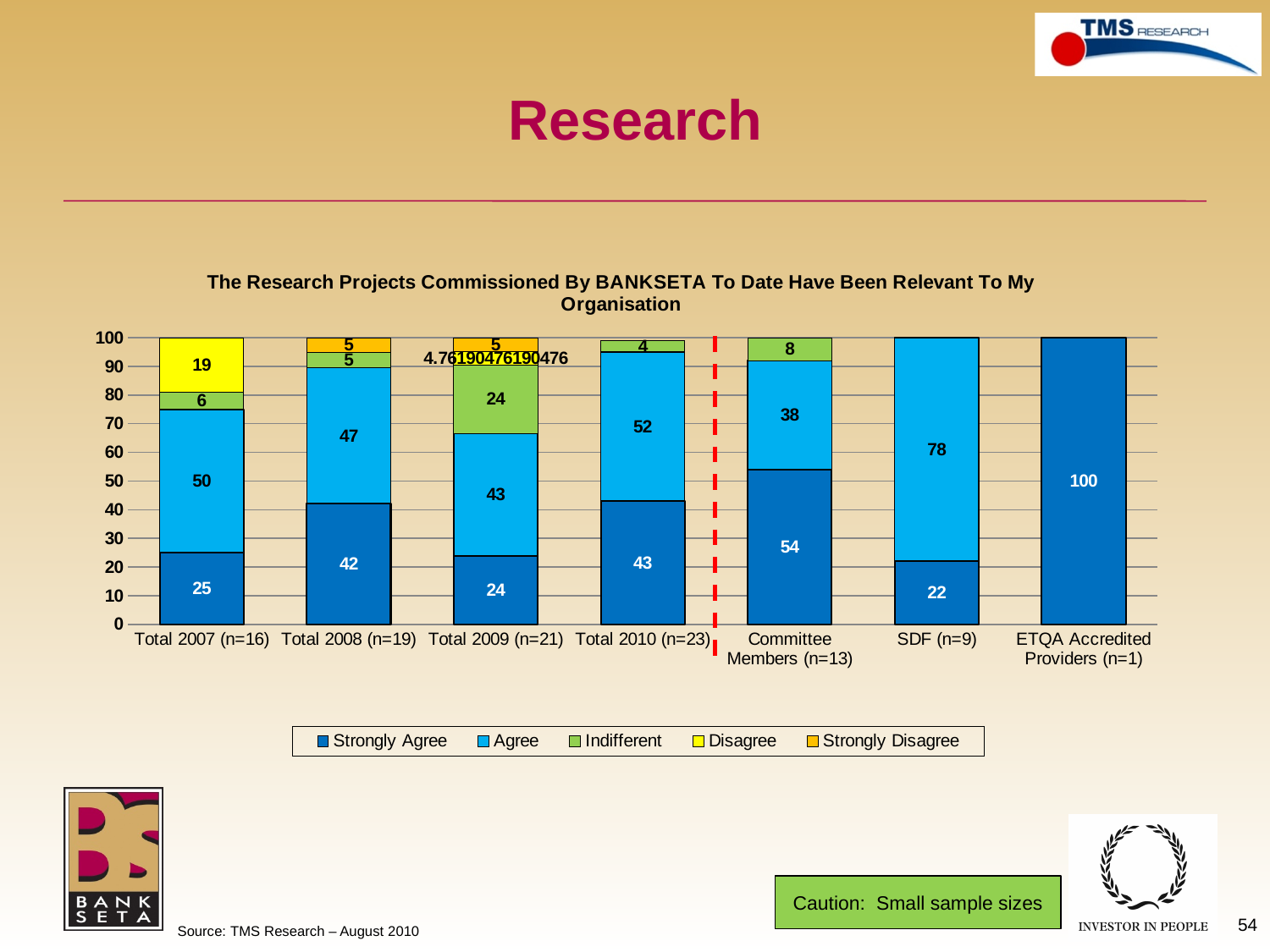
How many categories are shown on the x axis? 7 What is the total of the stacked bar for Total 2010 (n=23)? 99 Which is larger: the Strongly Agree value for Total 2008 (n=19) or for Total 2009 (n=21)? Total 2008 (n=19) What is the Indifferent value for Total 2009 (n=21)? 24 What type of chart is shown on the slide? Stacked bar chart What is the difference between the Agree values for SDF (n=9) and Committee Members (n=13)? 40 What is the Strongly Agree value for Committee Members (n=13)? 54 What is the Disagree value for Total 2007 (n=16)? 19 How many series does the legend list? 5 What is the Agree value for SDF (n=9)? 78 Which category has the highest Strongly Agree value? ETQA Accredited Providers (n=1)